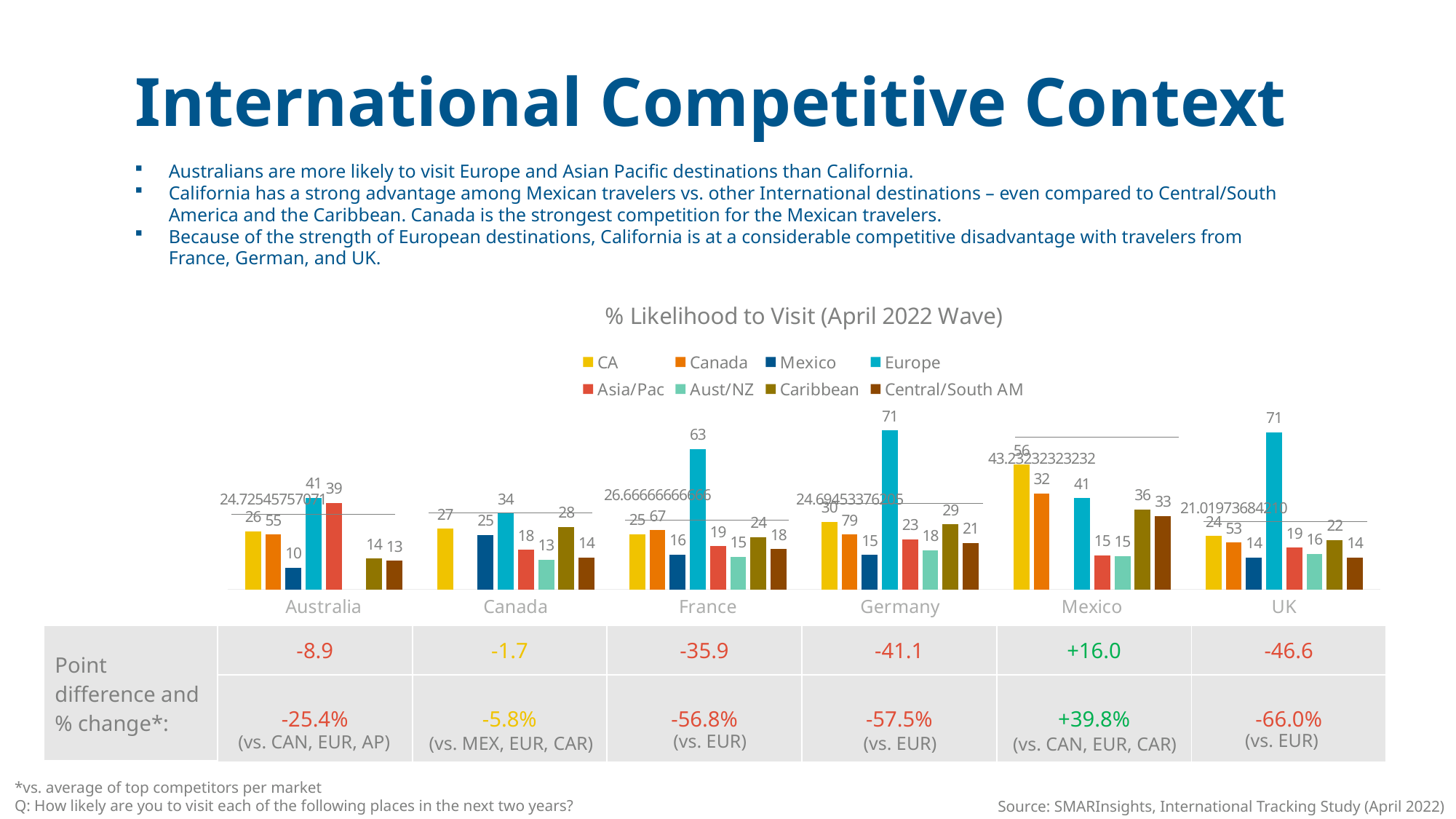
Which series has the lowest value in the Australia category? Mexico What is the value for CA in the Mexico category? 56 What type of chart is shown on the slide? Bar chart How many market categories are shown on the x axis? 6 What is the value for Mexico in the Australia category? 10 What is the difference between the Europe and CA values in the France category? 38 Which series has the highest value in the Mexico category? CA What is the value for Caribbean in the Mexico category? 36 What is the value for Europe in the France category? 63 In the UK category, which is larger: the Europe value or the CA value? Europe How many series does the legend list? 8 What is the value for Europe in the Germany category? 71